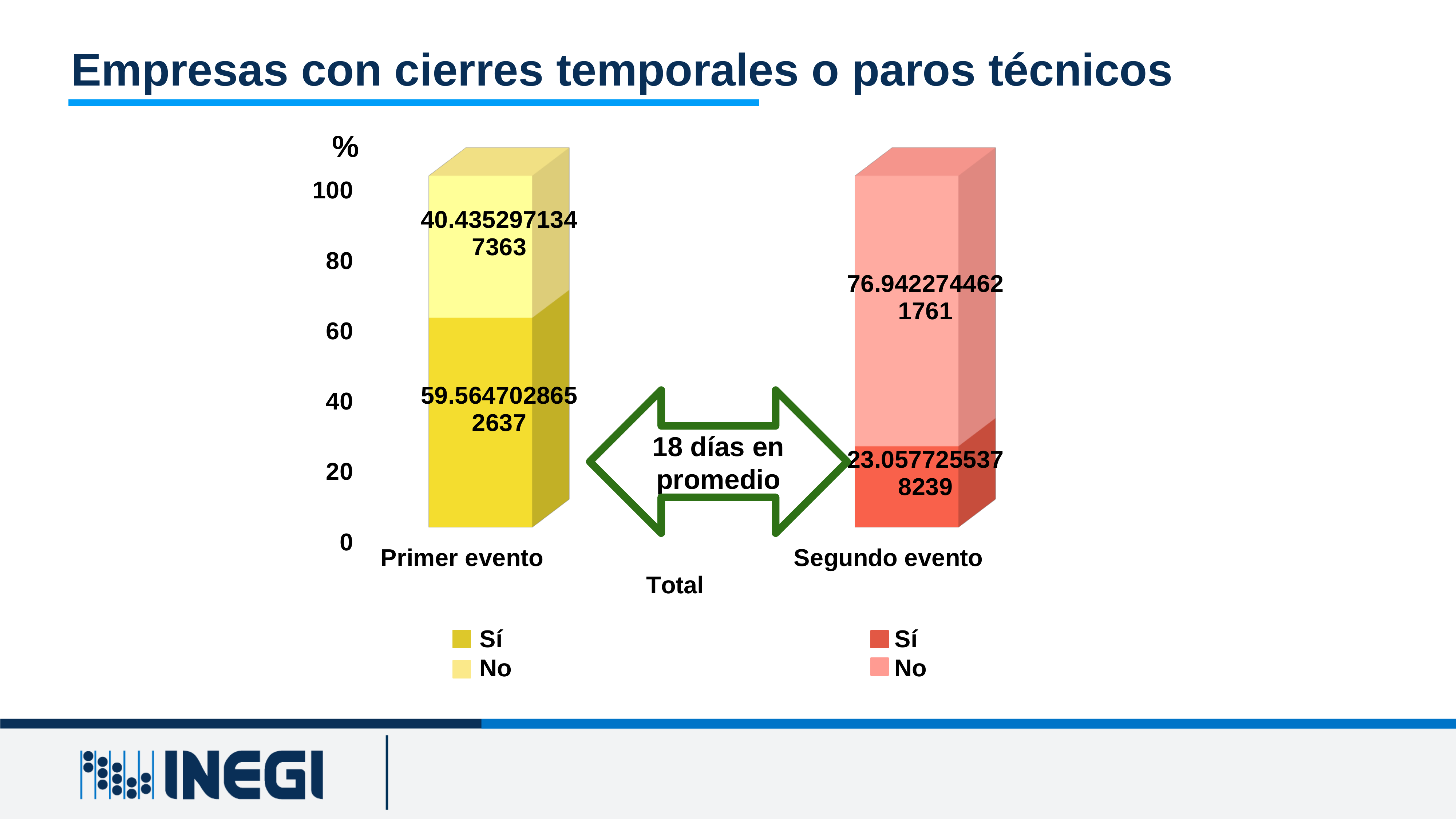
In the Primer evento chart, what is the difference between the Sí and No values? 19.1294057305274 What text is written inside the arrow between the two charts? 18 días en promedio In the Segundo evento chart, which is larger, Sí or No? No What kind of chart is used for Primer evento? Bar chart In the Segundo evento chart, what is the value for Sí? 23.0577255378239 How many series does the legend of the Segundo evento chart list? 2 In the Segundo evento chart, is the value for Sí greater or less than 40? less In the Segundo evento chart, what is the value for No? 76.9422744621761 In the Primer evento chart, which is larger, Sí or No? Sí In the Primer evento chart, what is the value for No? 40.4352971347363 In the Primer evento chart, what is the value for Sí? 59.5647028652637 In the Primer evento chart, what is the total of the stacked bar? 100